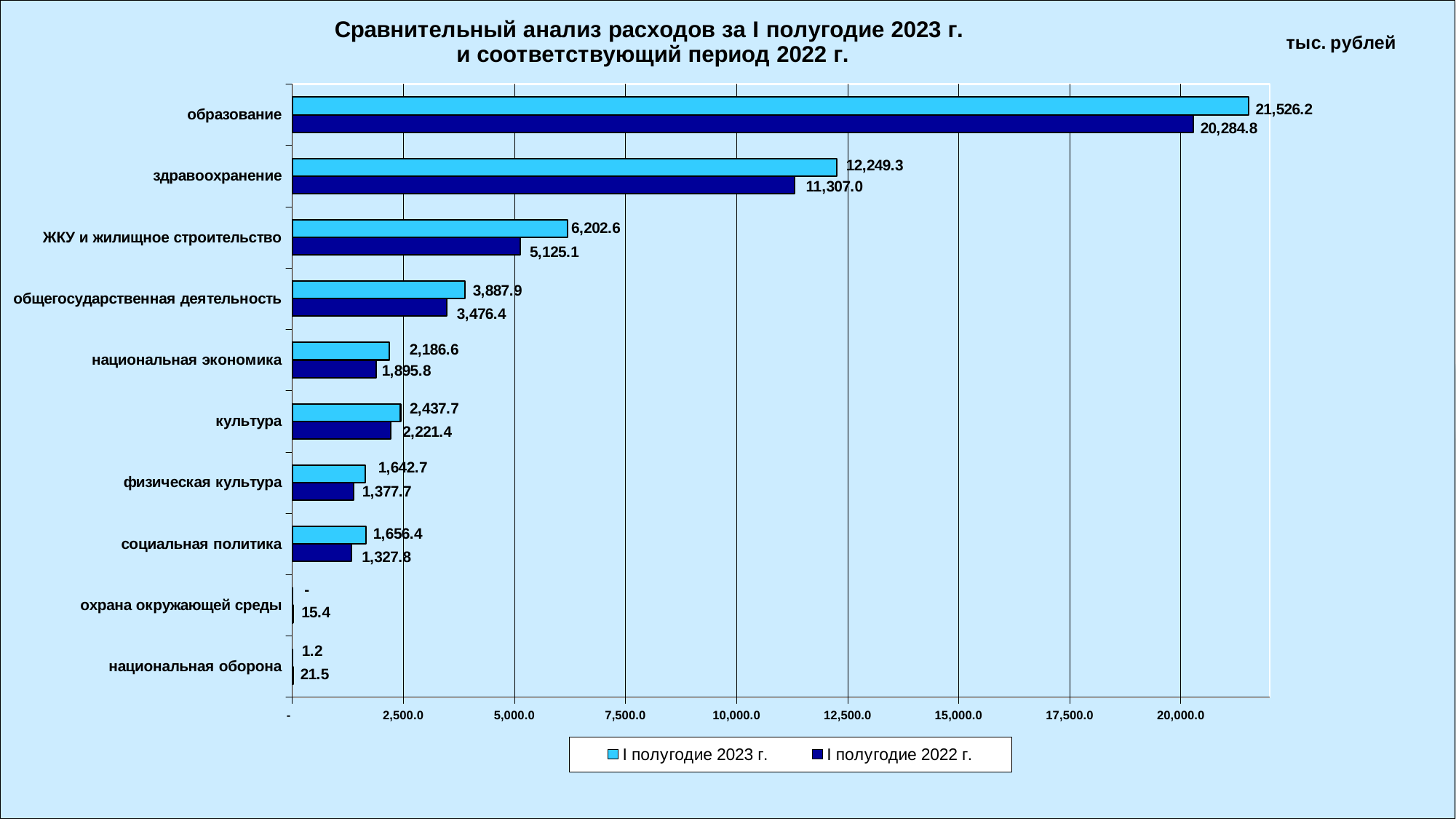
Which category has the lowest value in the I полугодие 2022 г. series? охрана окружающей среды What is the value for образование in the I полугодие 2023 г. series? 21,526.2 What is the value for национальная оборона in the I полугодие 2022 г. series? 21.5 How many categories are shown on the chart? 10 Which category has the highest value in the I полугодие 2023 г. series? образование Is the I полугодие 2023 г. value for здравоохранение greater or less than 10,000.0? greater What is the value for здравоохранение in the I полугодие 2022 г. series? 11,307.0 What is the value for культура in the I полугодие 2023 г. series? 2,437.7 What kind of chart is shown on the slide? bar chart How many series does the legend list? 2 What is the difference between the I полугодие 2023 г. and I полугодие 2022 г. values for образование? 1,241.4 Which is larger for ЖКУ и жилищное строительство: the I полугодие 2023 г. value or the I полугодие 2022 г. value? I полугодие 2023 г.